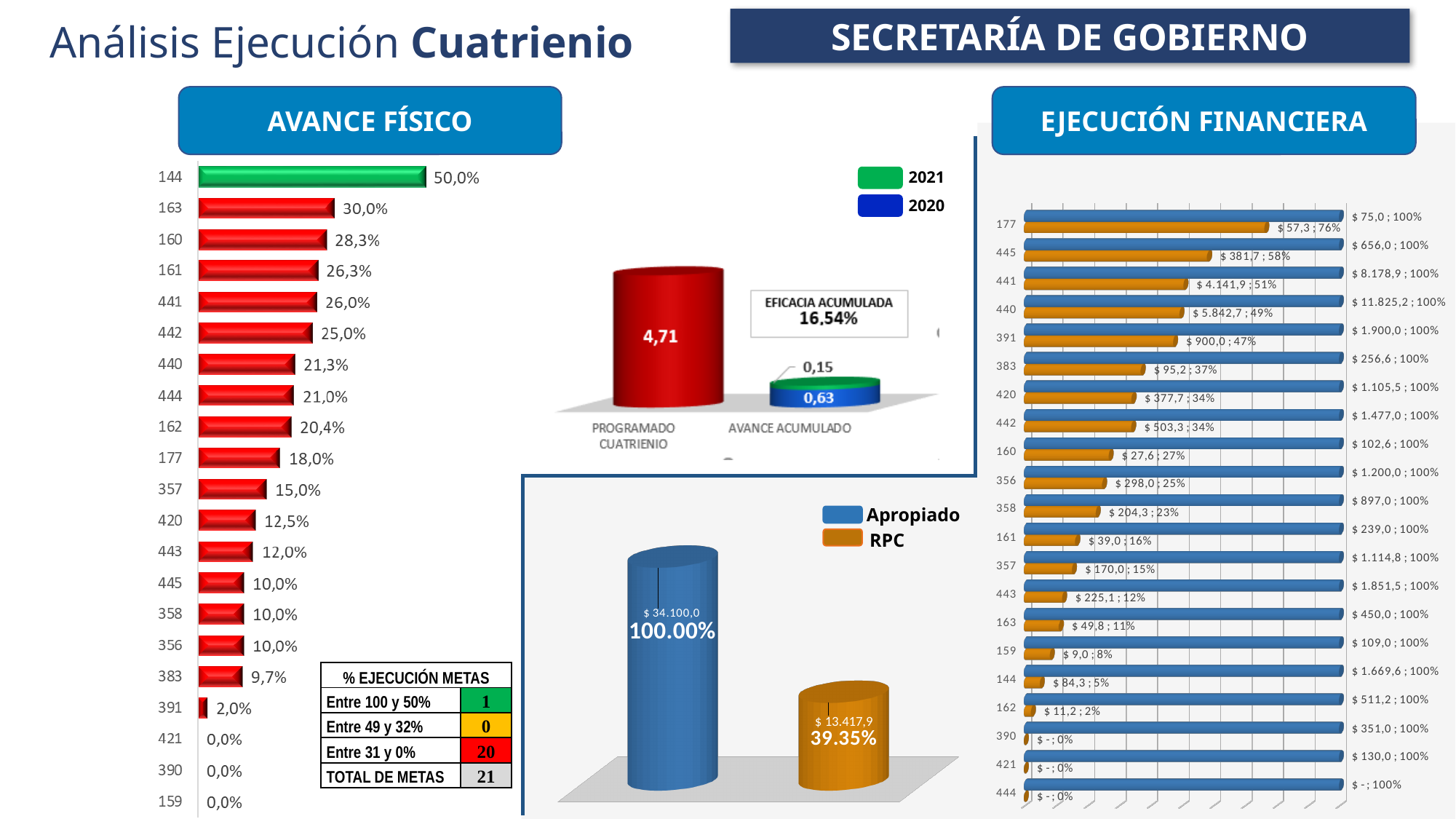
How many categories are shown in the AVANCE FÍSICO chart? 21 In the AVANCE FÍSICO chart, what is the difference between the values for 144 and 163? 20,0% In the Apropiado / RPC cylinder chart at the bottom centre, what amount is shown for Apropiado? $ 34.100,0 In the AVANCE FÍSICO chart, which category has the highest value? 144 In the Apropiado / RPC cylinder chart at the bottom centre, what percentage is shown for RPC? 39.35% In the AVANCE FÍSICO chart, which is larger: the value for 441 or the value for 442? 441 How many series does the legend of the EJECUCIÓN FINANCIERA chart list? 2 In the PROGRAMADO CUATRIENIO / AVANCE ACUMULADO chart, what is the 2020 value for AVANCE ACUMULADO? 0,63 In the PROGRAMADO CUATRIENIO / AVANCE ACUMULADO chart, what is the value for PROGRAMADO CUATRIENIO? 4,71 In the EJECUCIÓN FINANCIERA chart, what is the RPC value for category 441? $ 4.141,9 ; 51% What kind of chart is the EJECUCIÓN FINANCIERA chart? Bar chart In the AVANCE FÍSICO chart, what is the value for category 144? 50,0%